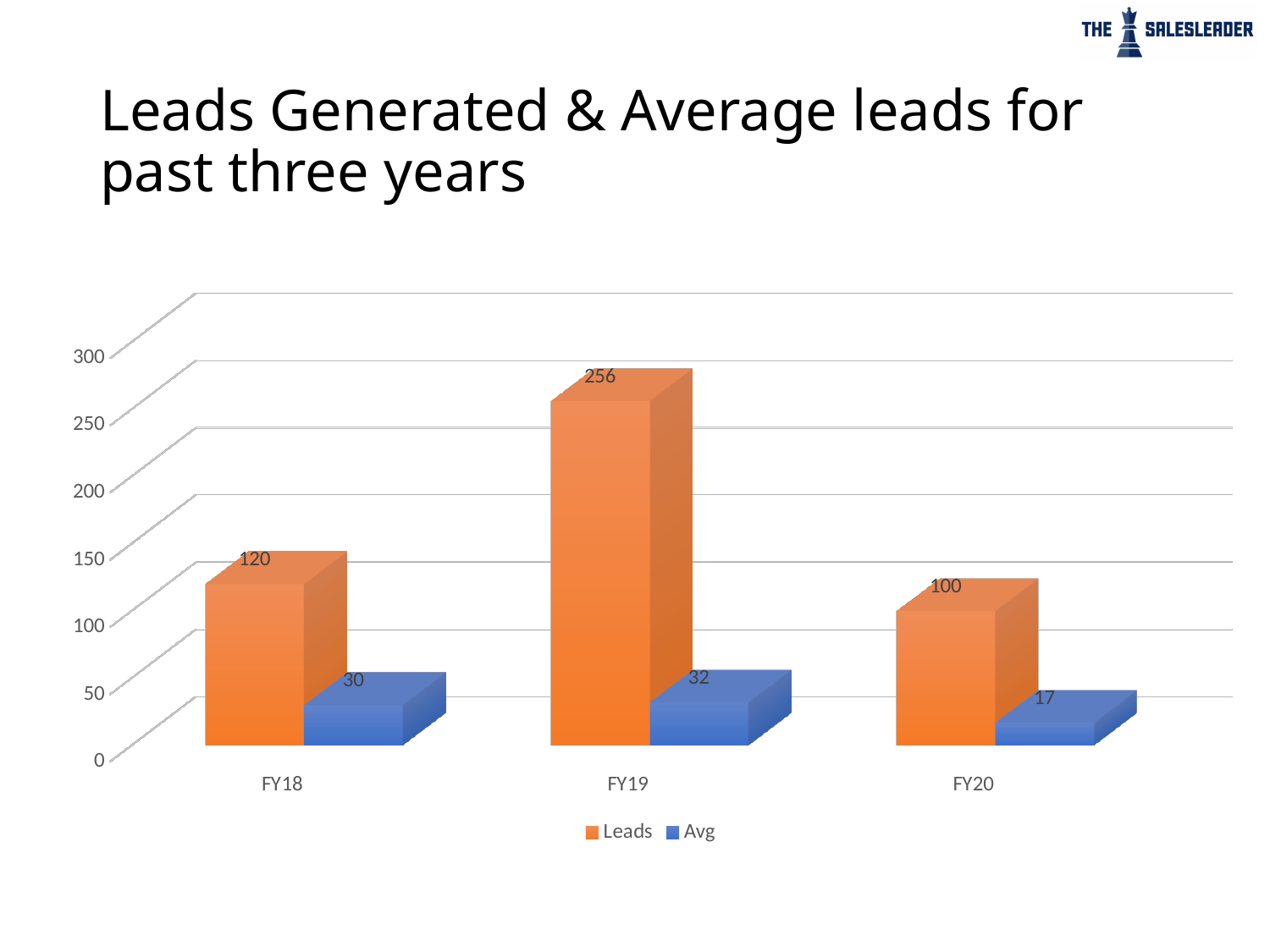
Which colour represents the Avg series in the legend? Blue Which year has the lowest Avg value? FY20 What is the value of Leads for FY18? 120 Which year has the highest Leads value? FY19 How many years are shown on the x axis? 3 What is the difference between the Leads values for FY19 and FY20? 156 What is the value of Leads for FY19? 256 Is the Leads value for FY19 greater or less than 250? greater What kind of chart is shown on the slide? Bar chart Which is larger, the Avg value for FY18 or for FY19? FY19 What is the value of Avg for FY20? 17 How many series does the legend list? 2